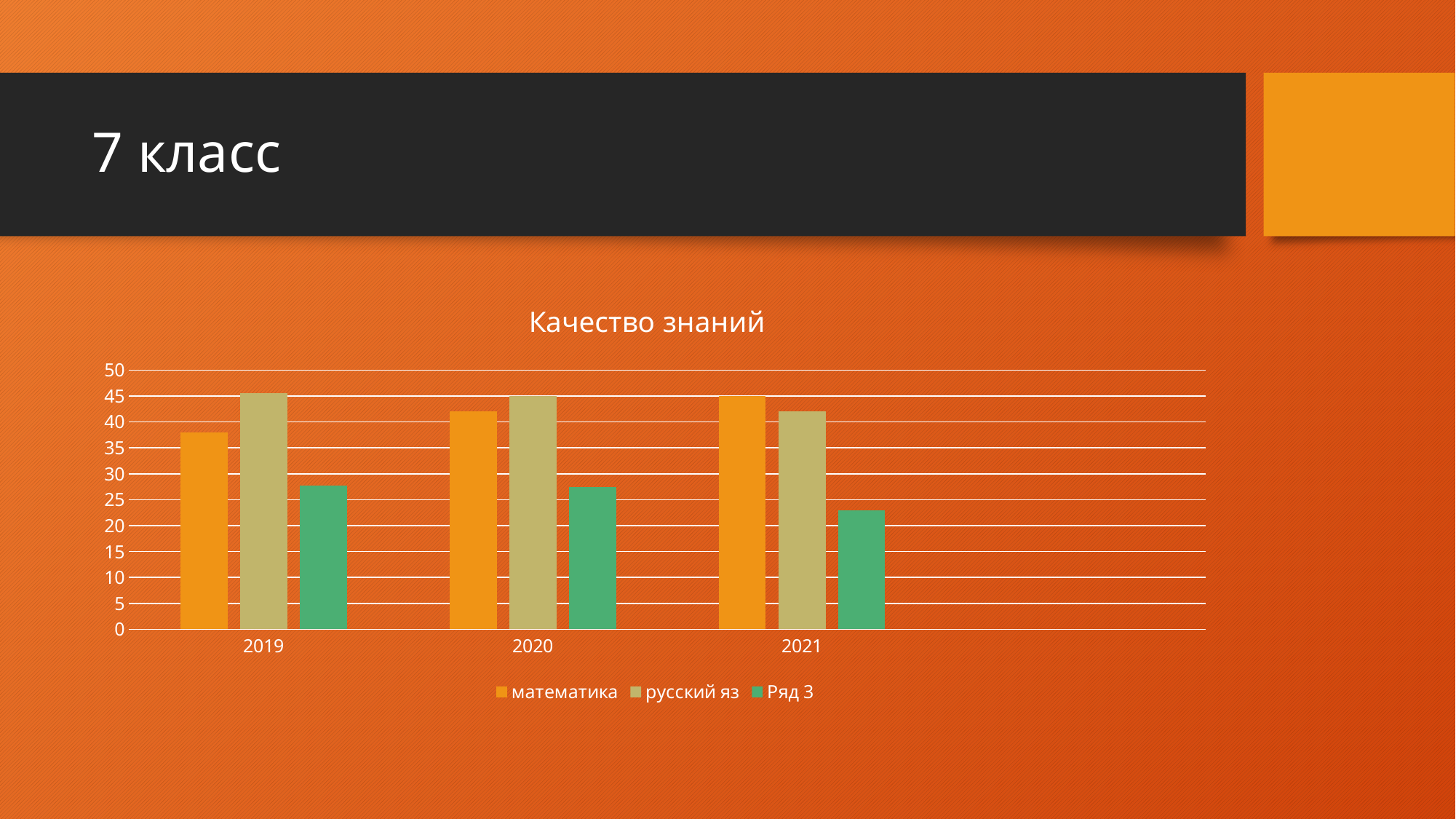
Is the value for Ряд 3 in 2019 greater or less than 25? greater Is the value for русский яз in 2019 greater or less than 40? greater How many series does the legend list? 3 Which series has the lowest value in 2021? Ряд 3 What kind of chart is shown on the slide? bar chart How many categories are shown on the x axis? 3 Is the value for Ряд 3 in 2021 greater or less than 25? less In 2019, which is larger: математика or русский яз? русский яз Do the values for математика rise or fall from 2019 to 2021? rise What is the title of the chart? Качество знаний In 2021, which is larger: математика or русский яз? математика